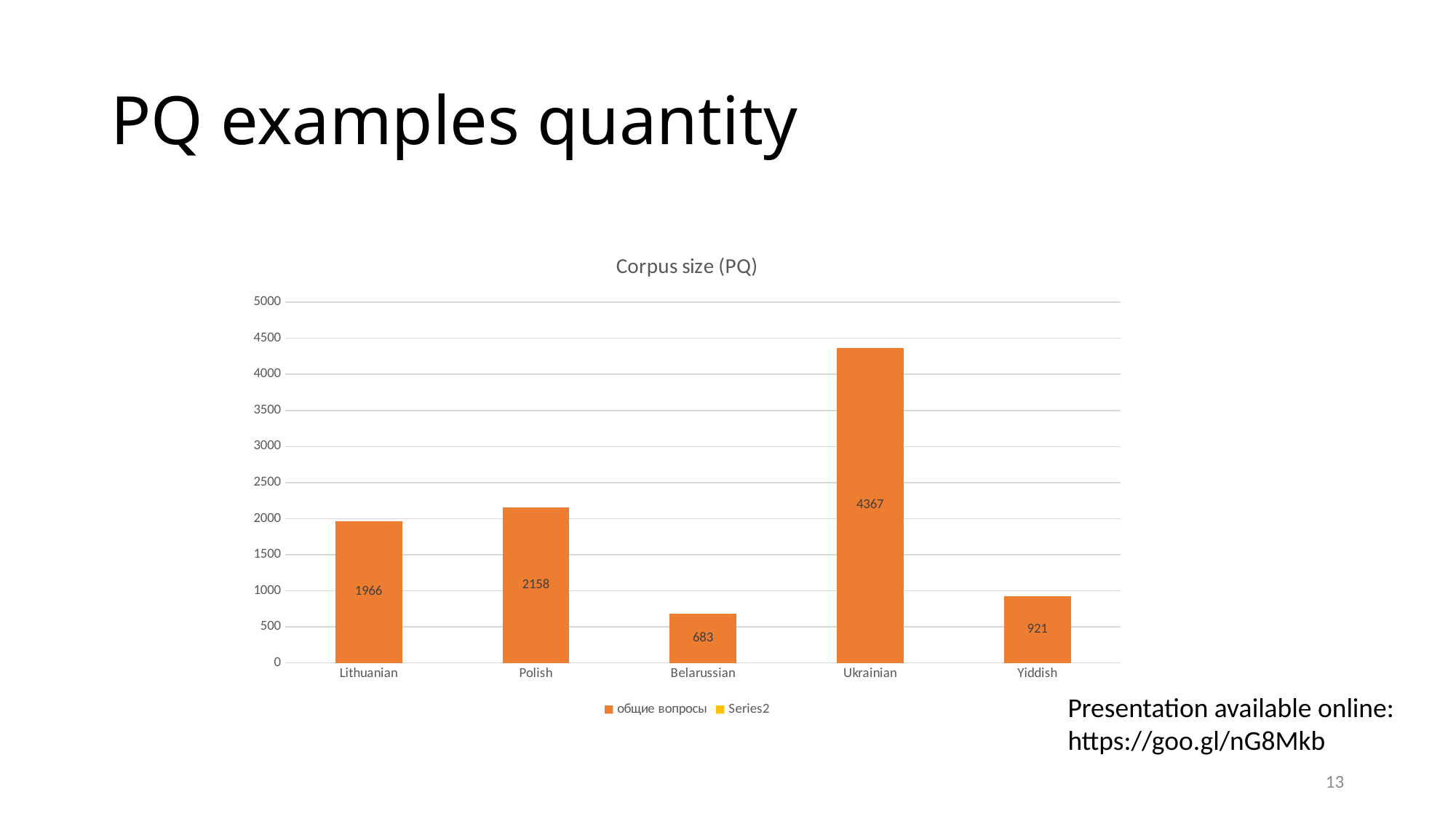
What is the difference between the corpus sizes for Ukrainian and Yiddish? 3446 What is the corpus size (PQ) for Ukrainian? 4367 What is the difference between the corpus sizes for Polish and Lithuanian? 192 How many series does the legend list? 2 Which language has the largest corpus size (PQ)? Ukrainian What is the corpus size (PQ) for Belarussian? 683 Which has a larger corpus size, Polish or Lithuanian? Polish What type of chart is shown on the slide? Bar chart What is the corpus size (PQ) for Yiddish? 921 Is the value for Ukrainian greater or less than 4000? greater How many languages are shown on the x axis? 5 Which language has the smallest corpus size (PQ)? Belarussian